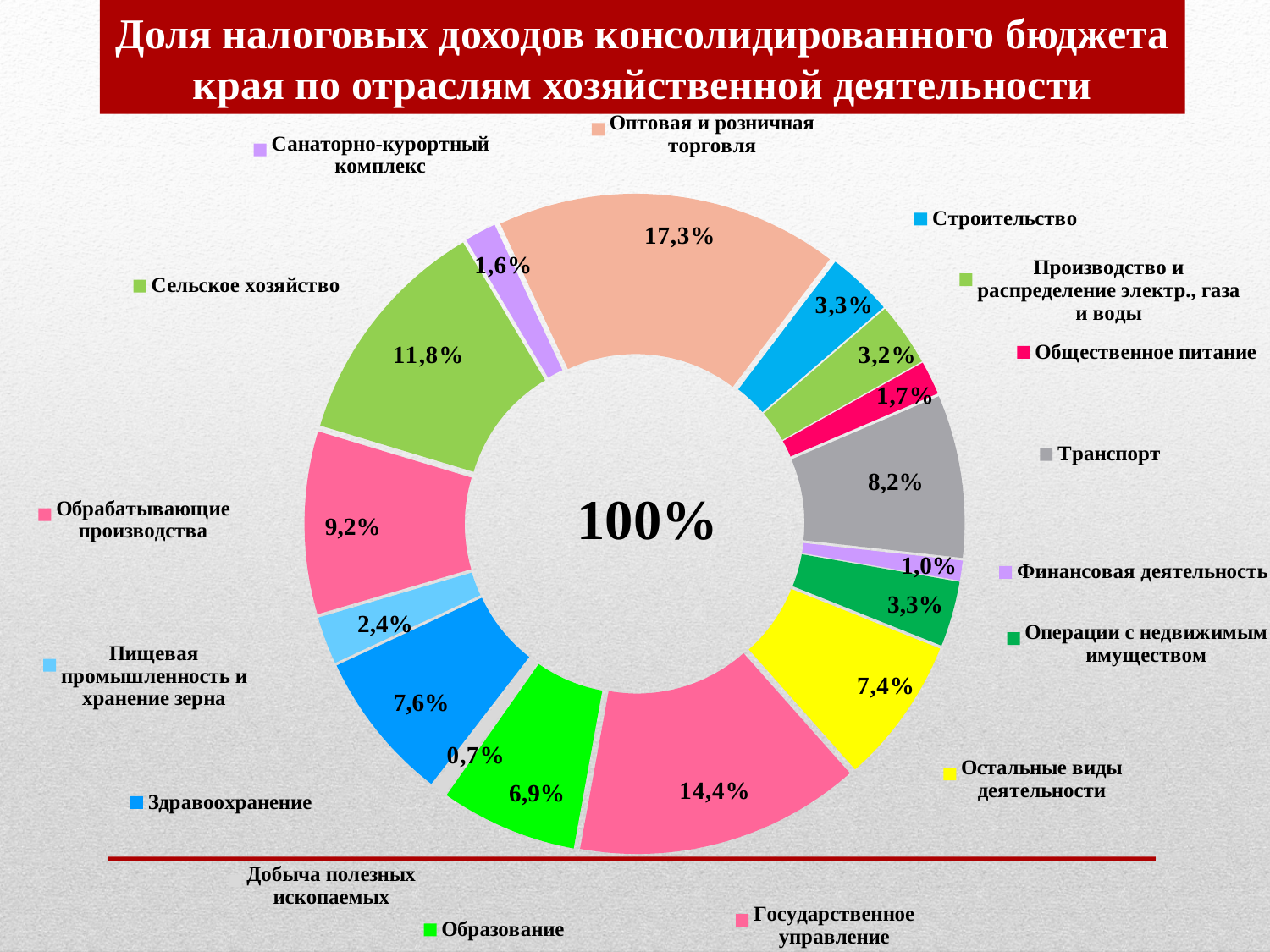
What is the title of the chart? Доля налоговых доходов консолидированного бюджета края по отраслям хозяйственной деятельности Which is larger: the share of Обрабатывающие производства or the share of Образование? Обрабатывающие производства How many sectors are shown in the chart? 16 Which sector has the smallest share of tax revenues? Добыча полезных ископаемых What is the difference between the shares of Оптовая и розничная торговля and Государственное управление? 2,9% What is the share for Сельское хозяйство? 11,8% What is the share for Здравоохранение? 7,6% What is the share for Государственное управление? 14,4% Which sector has the largest share of tax revenues? Оптовая и розничная торговля What is the share for Финансовая деятельность? 1,0% What kind of chart is shown on the slide? Pie chart (doughnut) What is the share for Транспорт? 8,2%